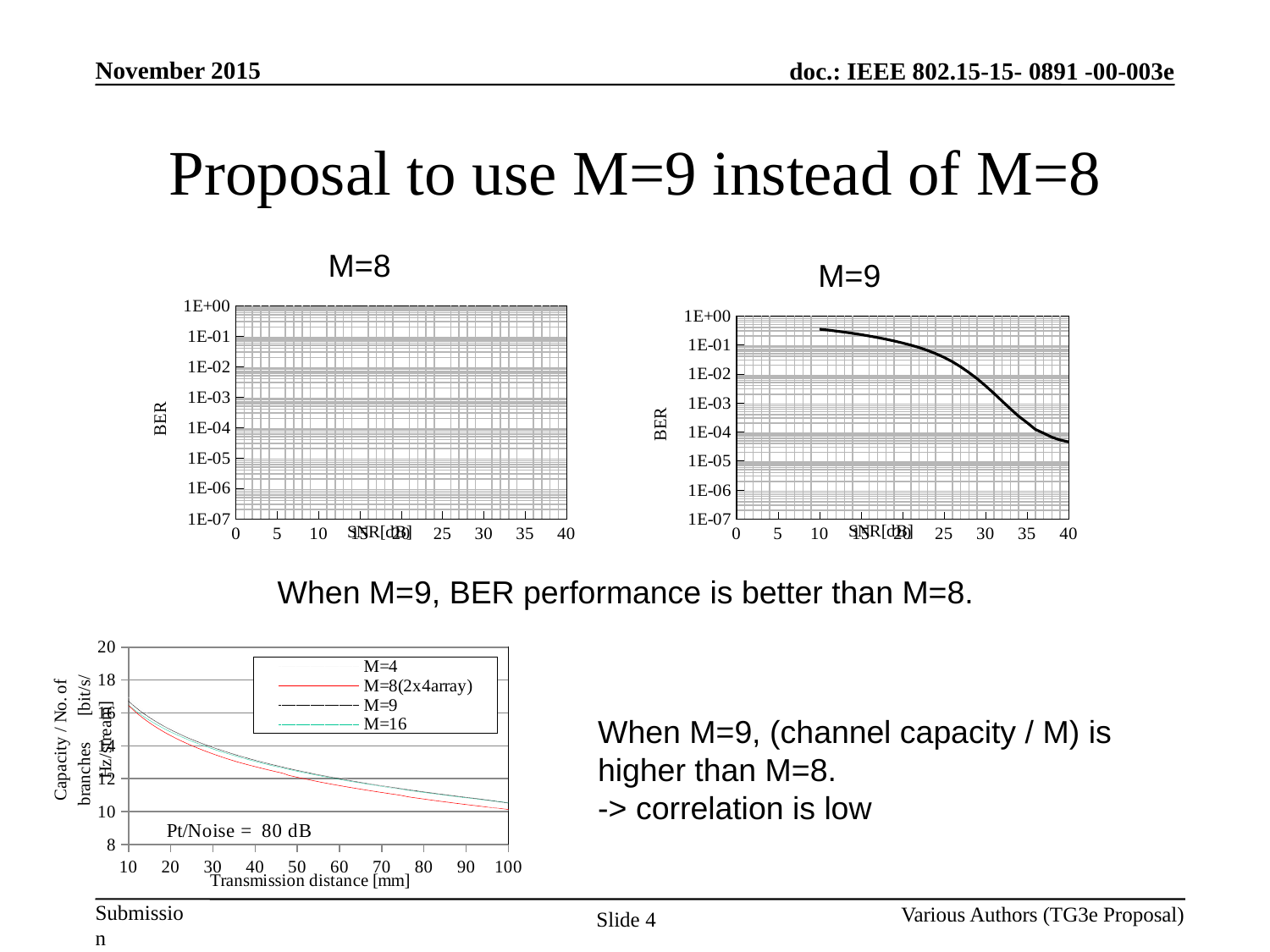
In the bottom-left capacity chart, is the M=9 value at 10 mm greater or less than 14? greater In the M=9 chart, is the BER at SNR 30 dB greater or less than 1E-04? greater In the M=9 chart, does BER rise or fall as SNR increases? fall In the bottom-left capacity chart, which is higher at 100 mm, M=9 or M=8(2x4array)? M=9 In the bottom-left capacity chart, is the M=9 value at 100 mm greater or less than 12? less What are the legend entries of the bottom-left capacity chart? M=4, M=8(2x4array), M=9, M=16 What is the x-axis label of the bottom-left capacity chart? Transmission distance [mm] How many series does the legend of the bottom-left capacity chart list? 4 What kind of chart is the M=9 chart? line chart In the bottom-left capacity chart, do the values rise or fall as transmission distance increases? fall